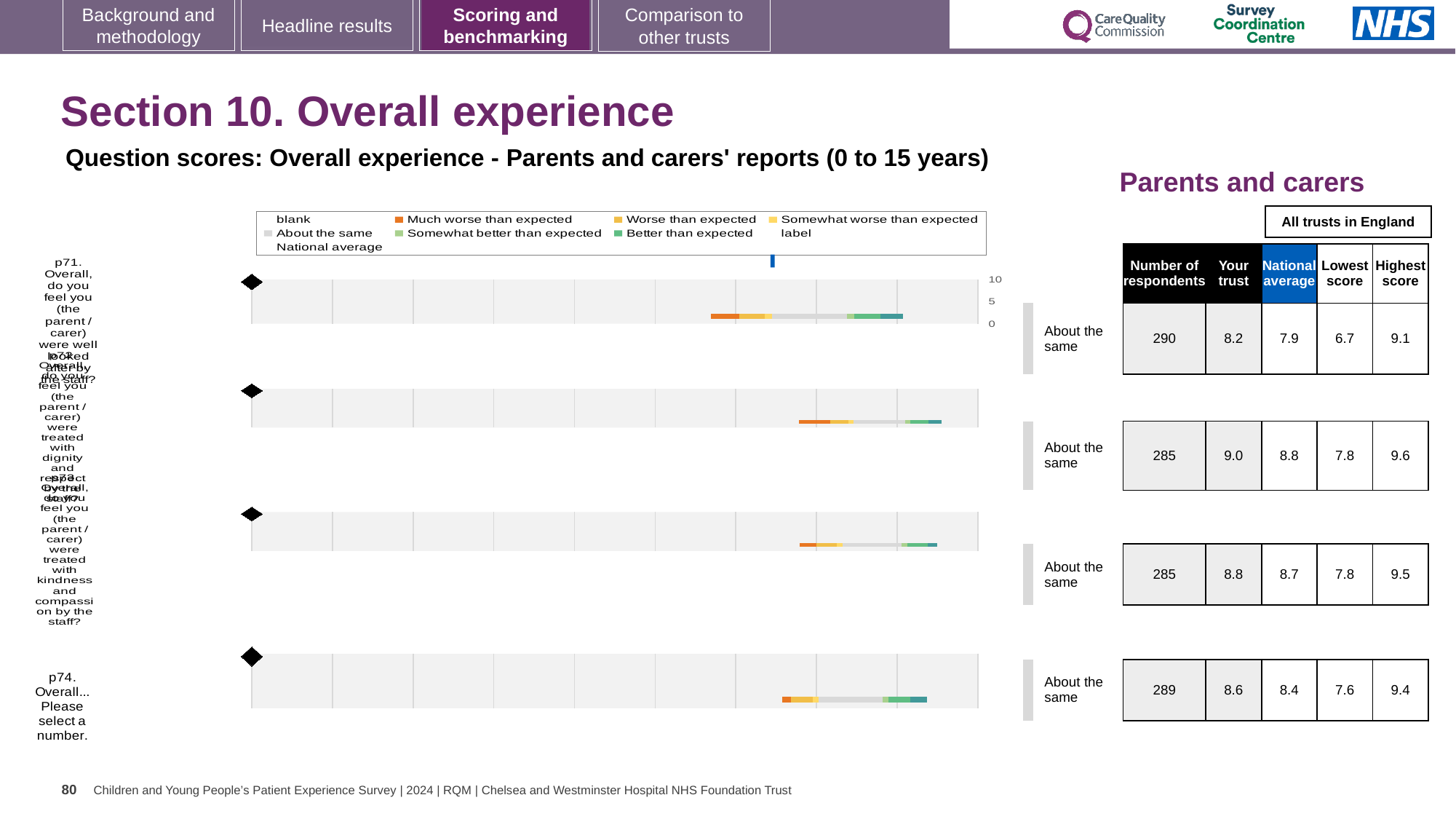
What benchmark category is shown beside each bar in the chart? About the same For p71, which is larger: the 'Your trust' score or the national average? Your trust In the table next to the chart, what is the highest score for p74? 9.4 In the table next to the chart, what is the 'Your trust' score for p71? 8.2 For p71, what is the difference between the 'Your trust' score and the national average shown in the table? 0.3 In the table next to the chart, what is the national average for p74 (Overall... Please select a number)? 8.4 For p74, what is the difference between the highest score and the lowest score shown in the table? 1.8 How many question rows (bars) are plotted in the chart? 4 What kind of chart is shown on the slide? bar chart Which row of the table has the highest 'Your trust' score? the second row (9.0) In the table next to the chart, what is the 'Your trust' score in the second row? 9.0 In the table next to the chart, what is the number of respondents for p71 (Overall, do you feel you were well looked after by the staff)? 290